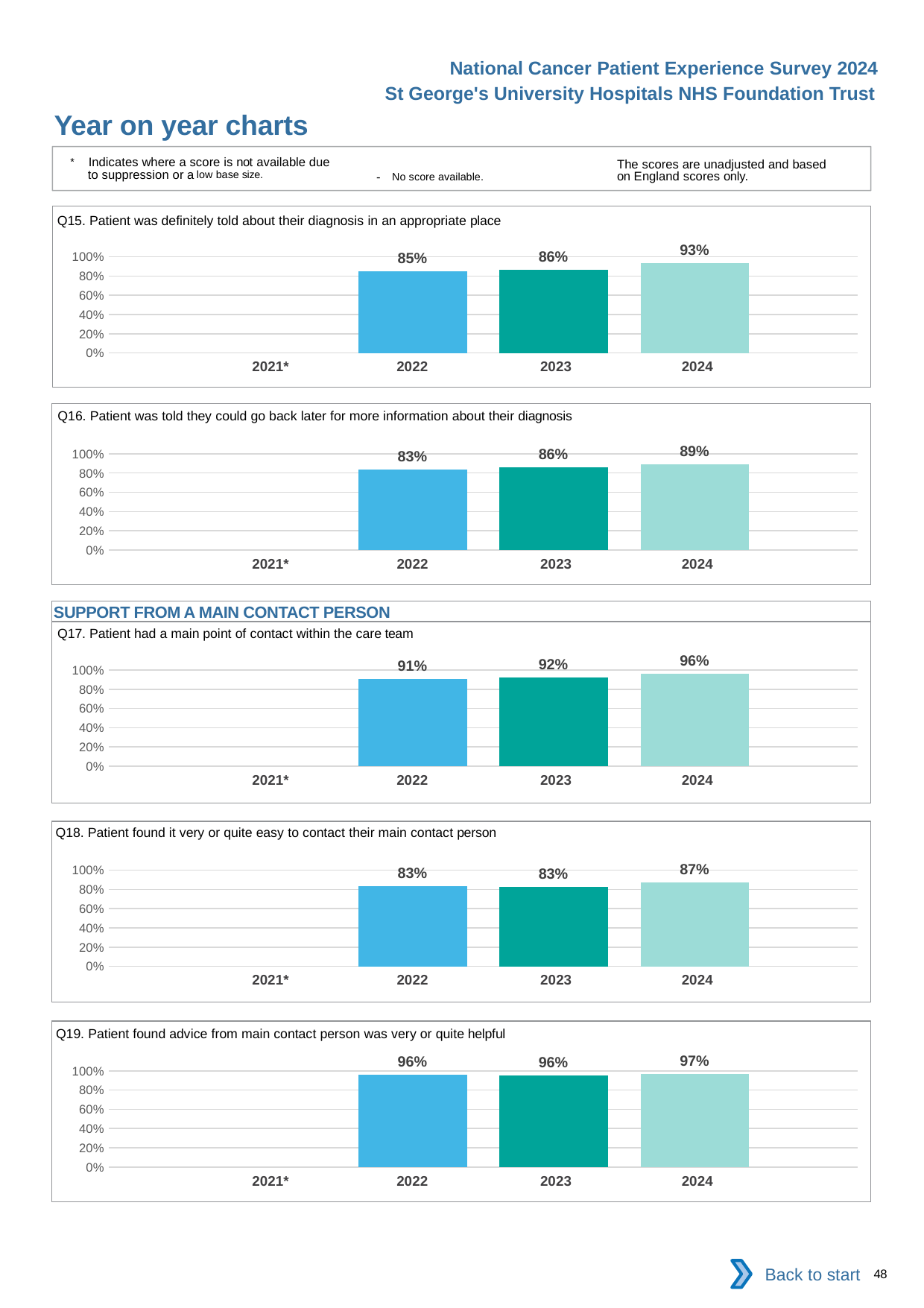
In the Q15 chart, which year has the highest value? 2024 In the Q18 chart (Patient found it very or quite easy to contact their main contact person), what is the value for 2024? 87% In the Q16 chart, what is the difference between the 2024 and 2022 values? 6% How many years are shown on the x axis of the Q15 chart? 4 In the Q19 chart, what is the difference between the 2024 and 2023 values? 1% In the Q16 chart (Patient was told they could go back later for more information about their diagnosis), what is the value for 2022? 83% In the Q15 chart (Patient was definitely told about their diagnosis in an appropriate place), what is the value for 2024? 93% In the Q17 chart (Patient had a main point of contact within the care team), what is the value for 2023? 92% What kind of chart is the Q17 chart? bar chart In the Q18 chart, which is larger, the value for 2024 or the value for 2023? 2024 In the Q19 chart (Patient found advice from main contact person was very or quite helpful), what is the value for 2022? 96% In the Q17 chart, do the values rise or fall from 2022 to 2024? rise